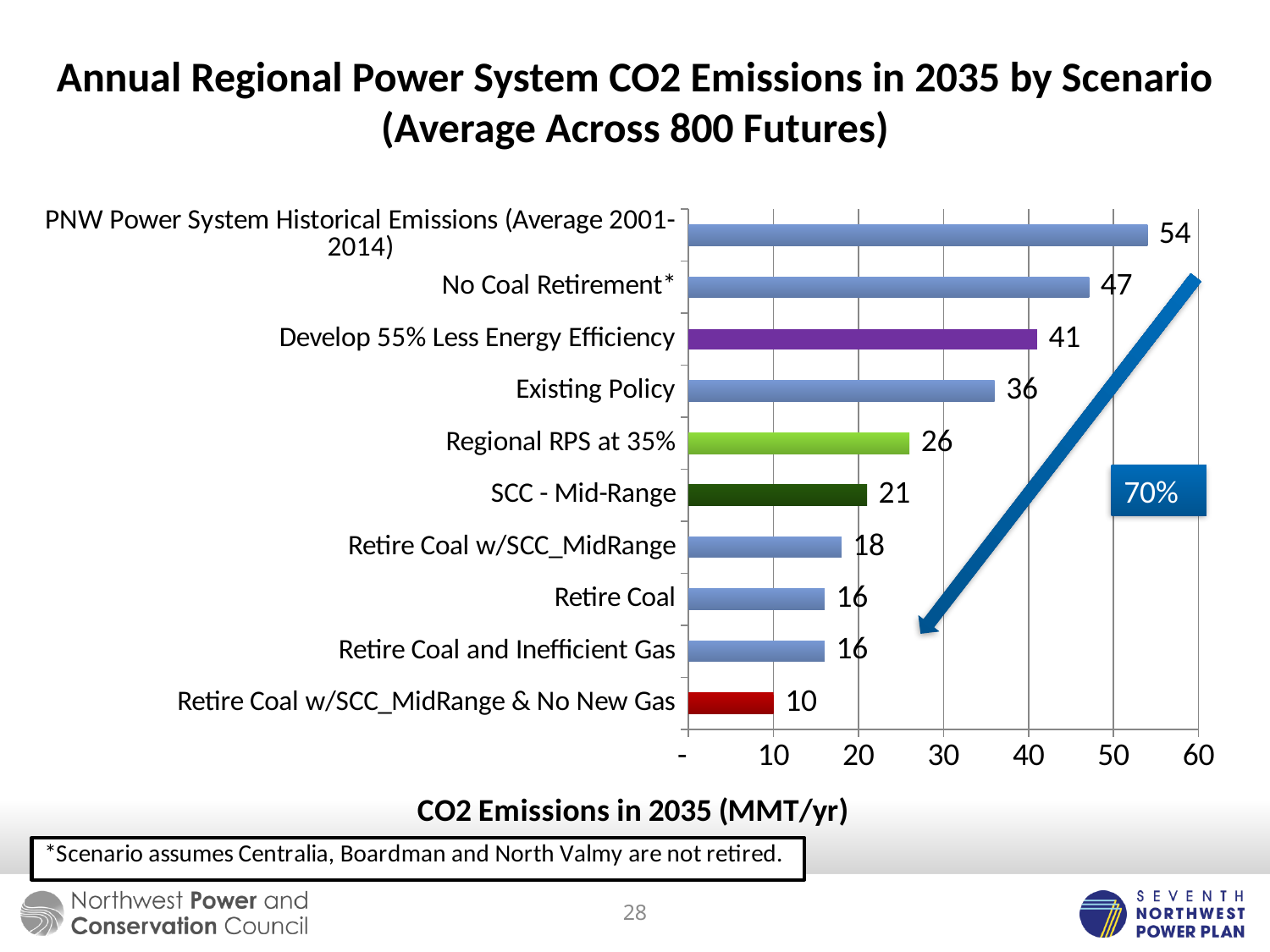
How many categories are plotted in the chart? 10 What is the difference between the Existing Policy value and the Retire Coal value? 20 What is the value for Regional RPS at 35%? 26 Which scenario has the lowest CO2 emissions value? Retire Coal w/SCC_MidRange & No New Gas What is the CO2 emissions value for the Existing Policy scenario? 36 What percentage is shown in the label next to the arrow on the chart? 70% What kind of chart is shown on the slide? bar chart Is the value for Retire Coal w/SCC_MidRange greater or less than 20? less Which is larger, the value for Develop 55% Less Energy Efficiency or the value for SCC - Mid-Range? Develop 55% Less Energy Efficiency Which category has the highest CO2 emissions value? PNW Power System Historical Emissions (Average 2001-2014) What is the x-axis title of the chart? CO2 Emissions in 2035 (MMT/yr) What is the value shown for the No Coal Retirement* scenario? 47